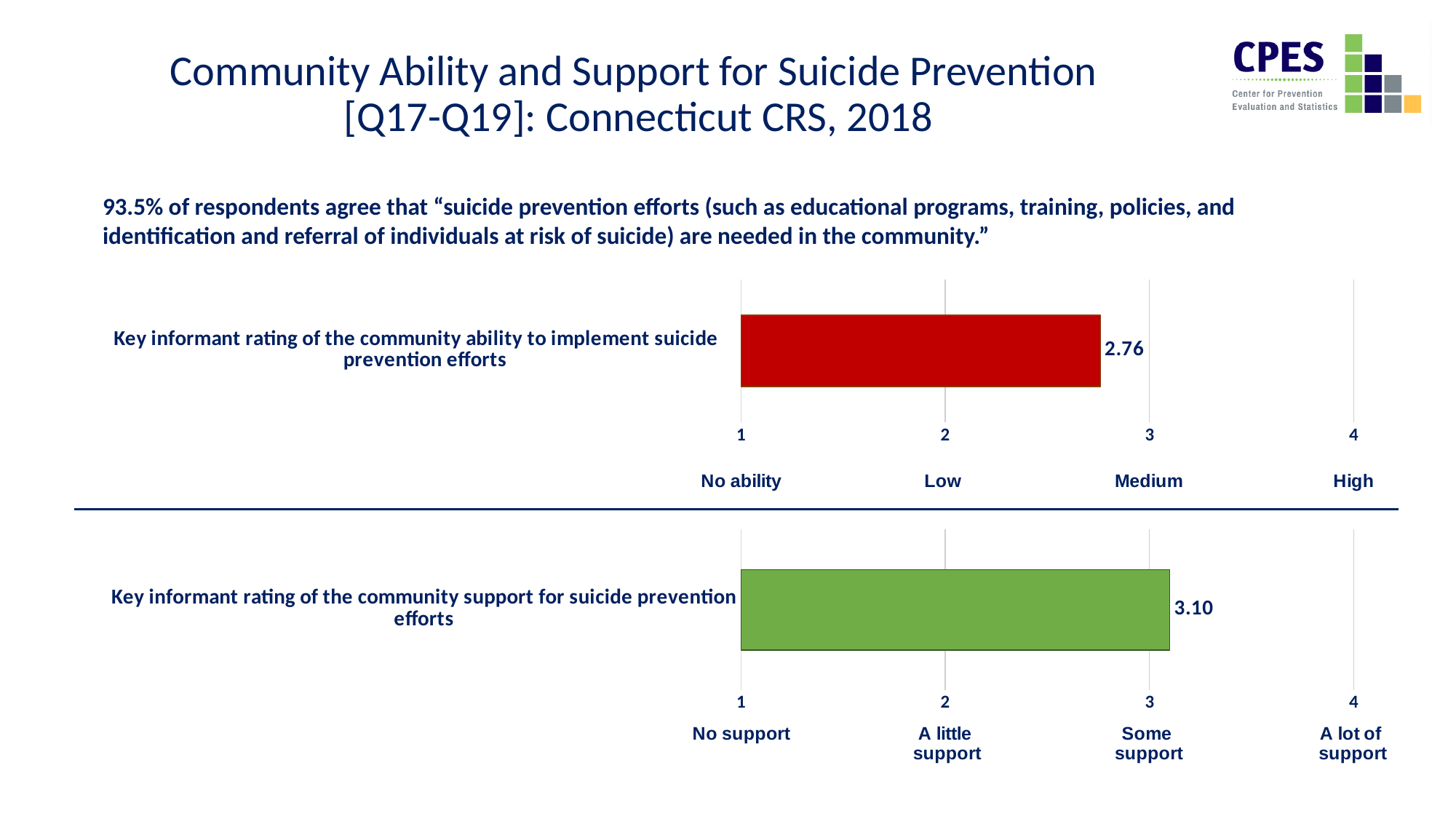
How many bars are plotted on the bottom chart? 1 Which is larger: the rating of community ability (top chart) or the rating of community support (bottom chart)? Community support On the top chart, is the community ability rating greater or less than 3? less On the bottom chart, is the community support rating greater or less than 4? less On the top chart, what is the key informant rating of the community ability to implement suicide prevention efforts? 2.76 What is the difference between the community support rating (bottom chart) and the community ability rating (top chart)? 0.34 On the bottom chart, what is the key informant rating of the community support for suicide prevention efforts? 3.10 On the top chart, what axis label corresponds to the value 4? High On the bottom chart, is the community support rating greater or less than 3? greater What kind of chart is the top chart showing the community ability rating? Bar chart On the bottom chart, what axis label corresponds to the value 1? No support